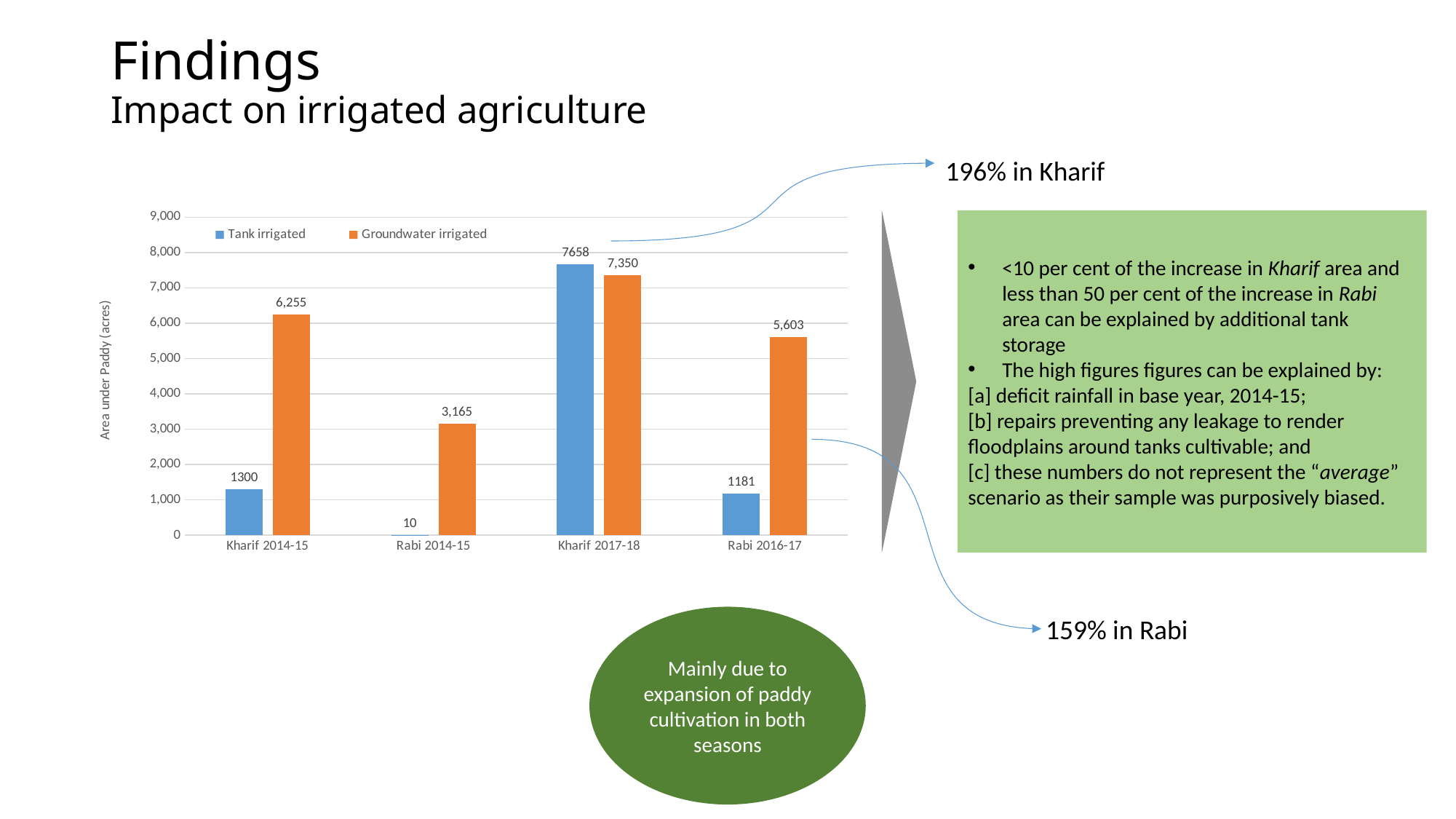
What is the label of the y axis? Area under Paddy (acres) What is the difference between the Groundwater irrigated values for Kharif 2014-15 and Rabi 2014-15? 3,090 Is the Tank irrigated value for Rabi 2016-17 greater or less than 2,000? less How many series does the legend list? 2 What is the Tank irrigated value for Rabi 2014-15? 10 How many categories are shown on the x axis? 4 Which category has the lowest Tank irrigated value? Rabi 2014-15 What is the Tank irrigated value for Kharif 2017-18? 7658 Which is larger for Kharif 2014-15: the Tank irrigated value or the Groundwater irrigated value? Groundwater irrigated What is the Groundwater irrigated value for Rabi 2016-17? 5,603 Which category has the highest Groundwater irrigated value? Kharif 2017-18 What kind of chart is shown on the slide? bar chart